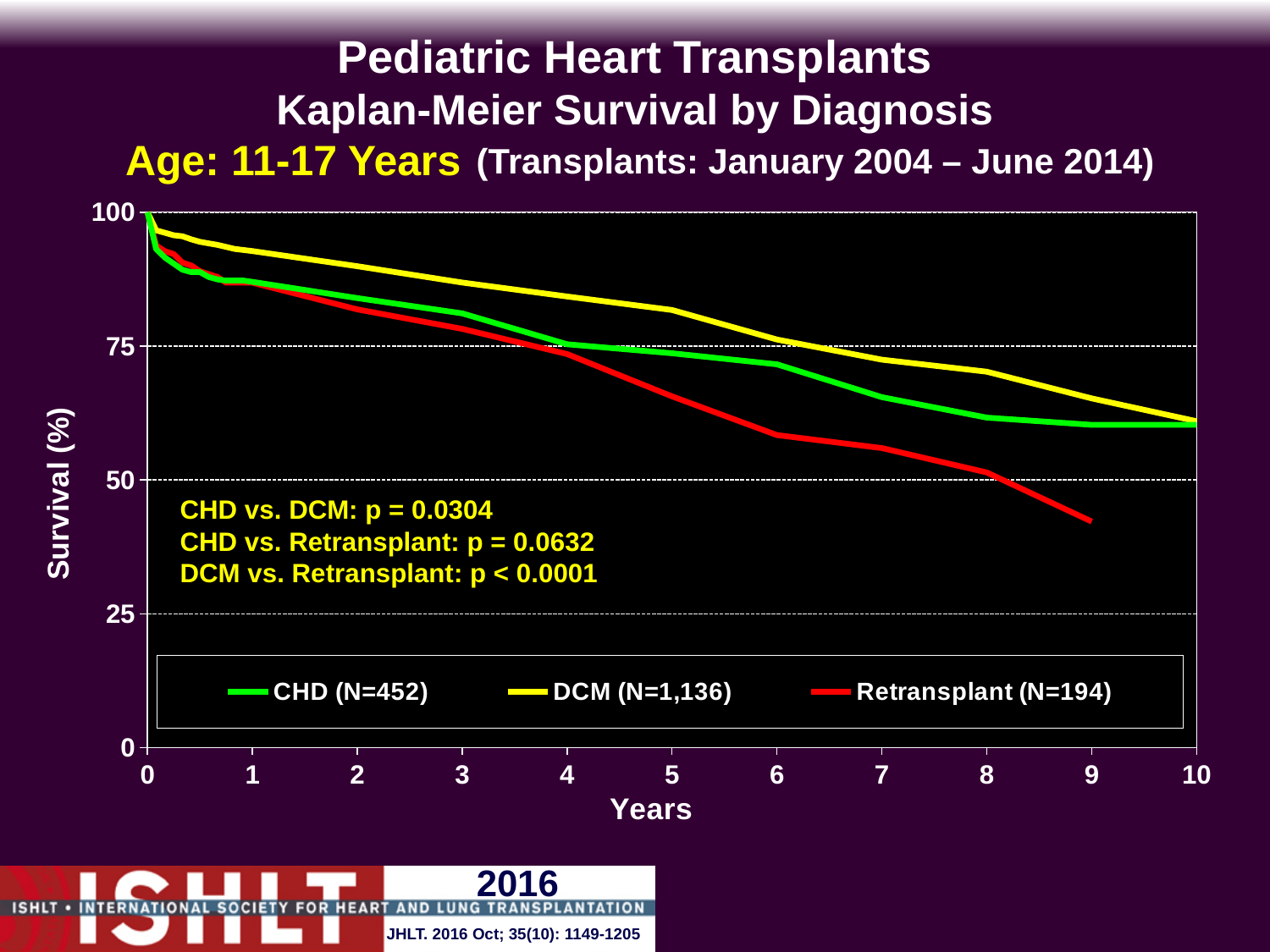
Does the survival for the DCM series rise or fall as years increase? fall Is the survival value for CHD at year 2 greater or less than 75? greater Which series has the lowest survival at year 8? Retransplant Is the survival value for Retransplant at year 6 greater or less than 50? greater How many series does the legend list? 3 What kind of chart is shown on the slide? line chart At year 9, which series has higher survival, DCM or Retransplant? DCM Is the survival value for Retransplant at year 9 greater or less than 50? less Which series has the highest survival at year 5? DCM What is the N shown in the legend for the DCM series? N=1,136